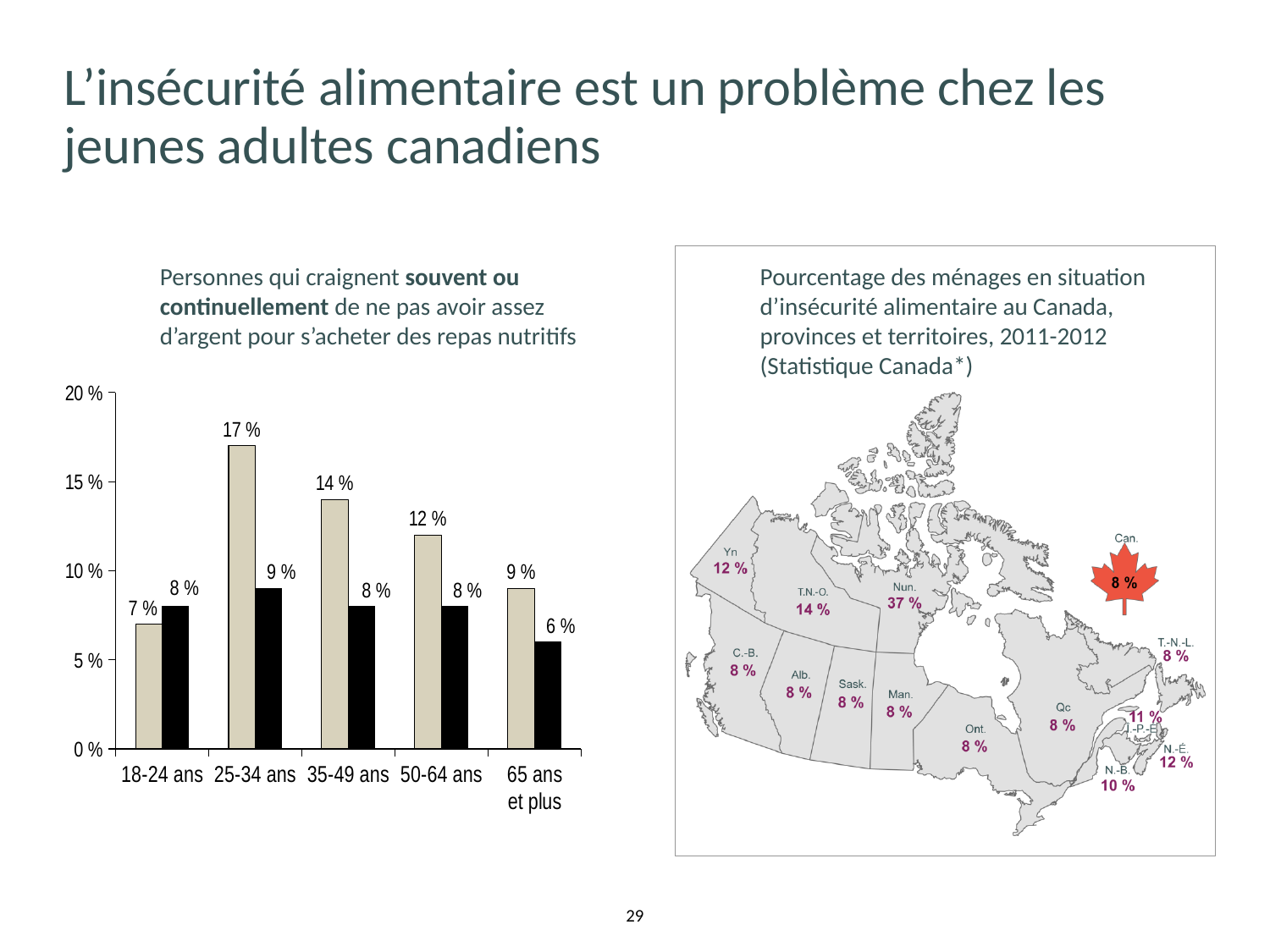
In the bar chart, what is the value of the beige bar for 18-24 ans? 7 % In the bar chart, what is the value of the beige bar for 25-34 ans? 17 % In the bar chart, what is the value of the black bar for 65 ans et plus? 6 % In the bar chart, what is the difference between the beige bar and the black bar for 35-49 ans? 6 % In the bar chart, do the beige bars rise or fall from 25-34 ans to 65 ans et plus? fall What type of chart is shown on the left of the slide? bar chart On the map on the right, what percentage is shown for Can. (Canada overall)? 8 % How many age groups are shown on the x axis of the bar chart? 5 In the bar chart, which is larger for 18-24 ans: the beige bar or the black bar? the black bar In the bar chart, which age group has the lowest black bar? 65 ans et plus In the bar chart, which age group has the highest beige bar? 25-34 ans On the map on the right, what percentage is shown for Nun. (Nunavut)? 37 %